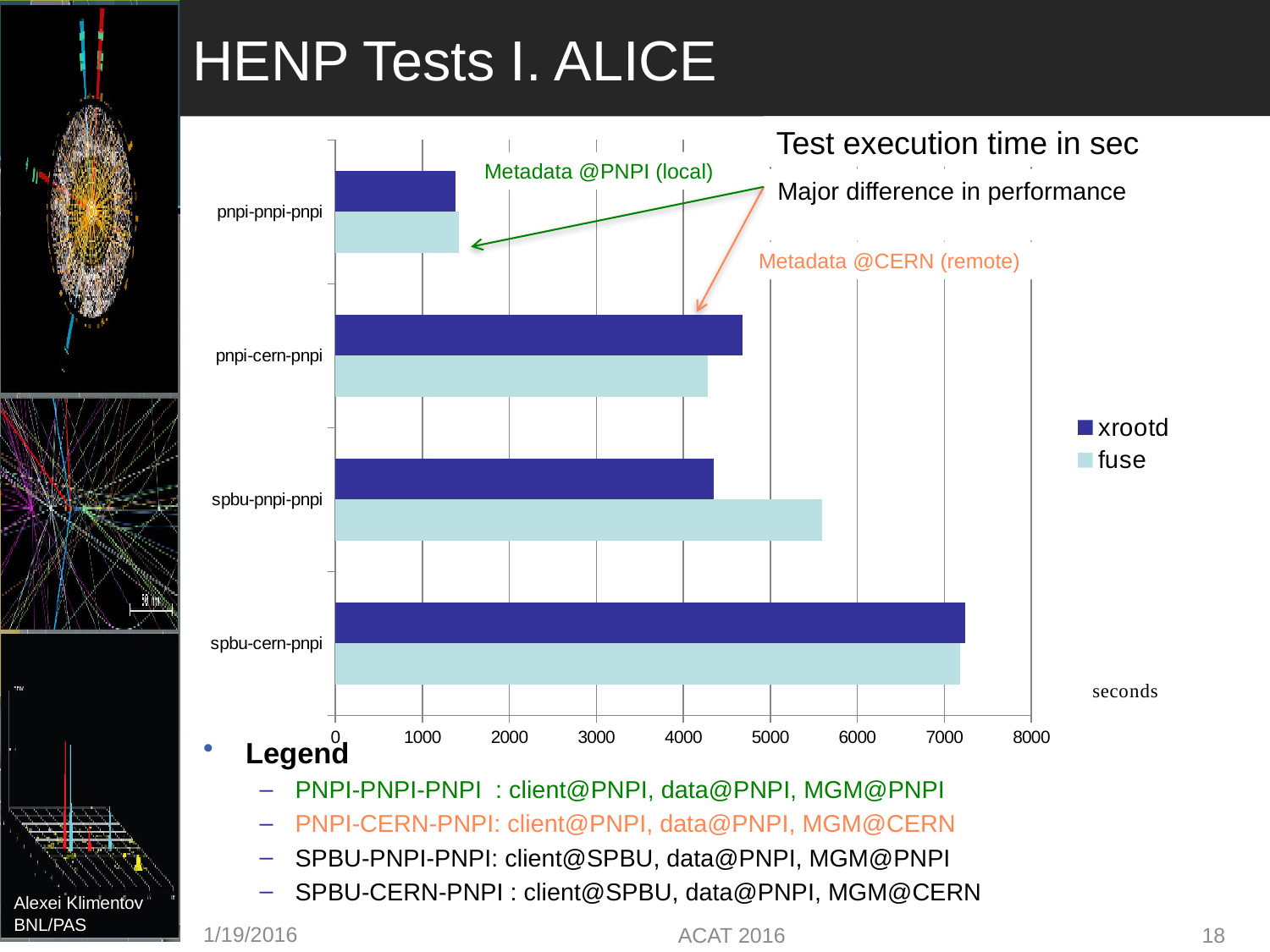
What are the two series named in the chart legend? xrootd and fuse Which configuration has the highest xrootd test execution time? spbu-cern-pnpi What unit is the x axis of the chart measured in? seconds Is the fuse value for spbu-pnpi-pnpi greater or less than 5000? greater How many series does the chart legend list? 2 How many test configurations (categories) are plotted on the chart? 4 Is the fuse value for pnpi-pnpi-pnpi greater or less than 2000? less For spbu-pnpi-pnpi, which is larger: the xrootd time or the fuse time? fuse Is the xrootd value for pnpi-cern-pnpi greater or less than 4000? greater Which configuration has the lowest fuse test execution time? pnpi-pnpi-pnpi What kind of chart is shown on the slide? bar chart